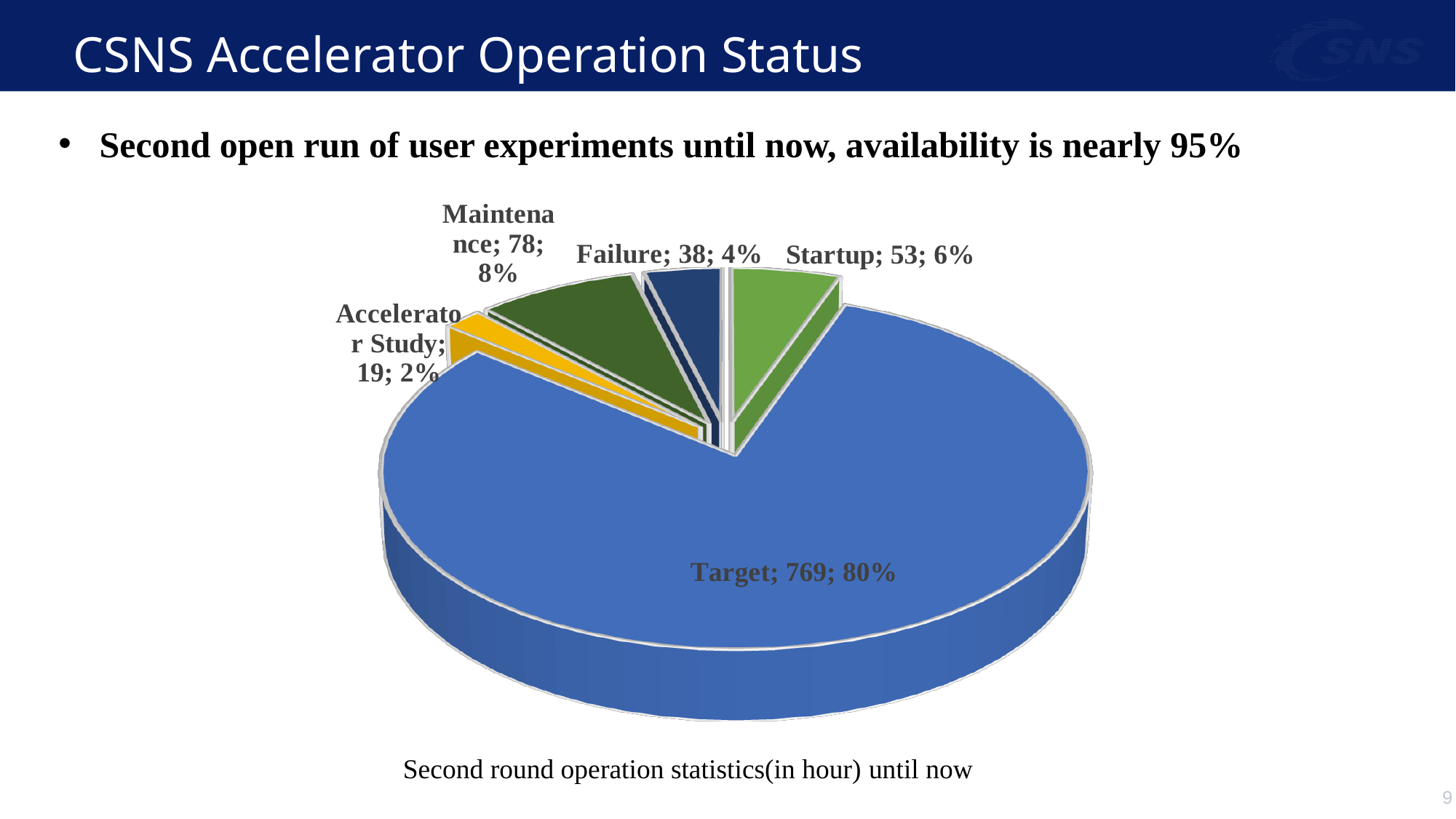
What is the value for Startup in the pie chart? 53 What is the value for Target in the pie chart? 769 What is the value for Maintenance in the pie chart? 78 What share of the pie does Target represent? 80% What share of the pie does Accelerator Study represent? 2% Which is larger, the value for Startup or the value for Failure? Startup Which category has the smallest slice in the pie chart? Accelerator Study What is the value for Failure in the pie chart? 38 What kind of chart is shown on the slide? pie chart How many slices does the pie chart have? 5 What is the difference between the Maintenance and Failure values? 40 Which category has the largest slice in the pie chart? Target